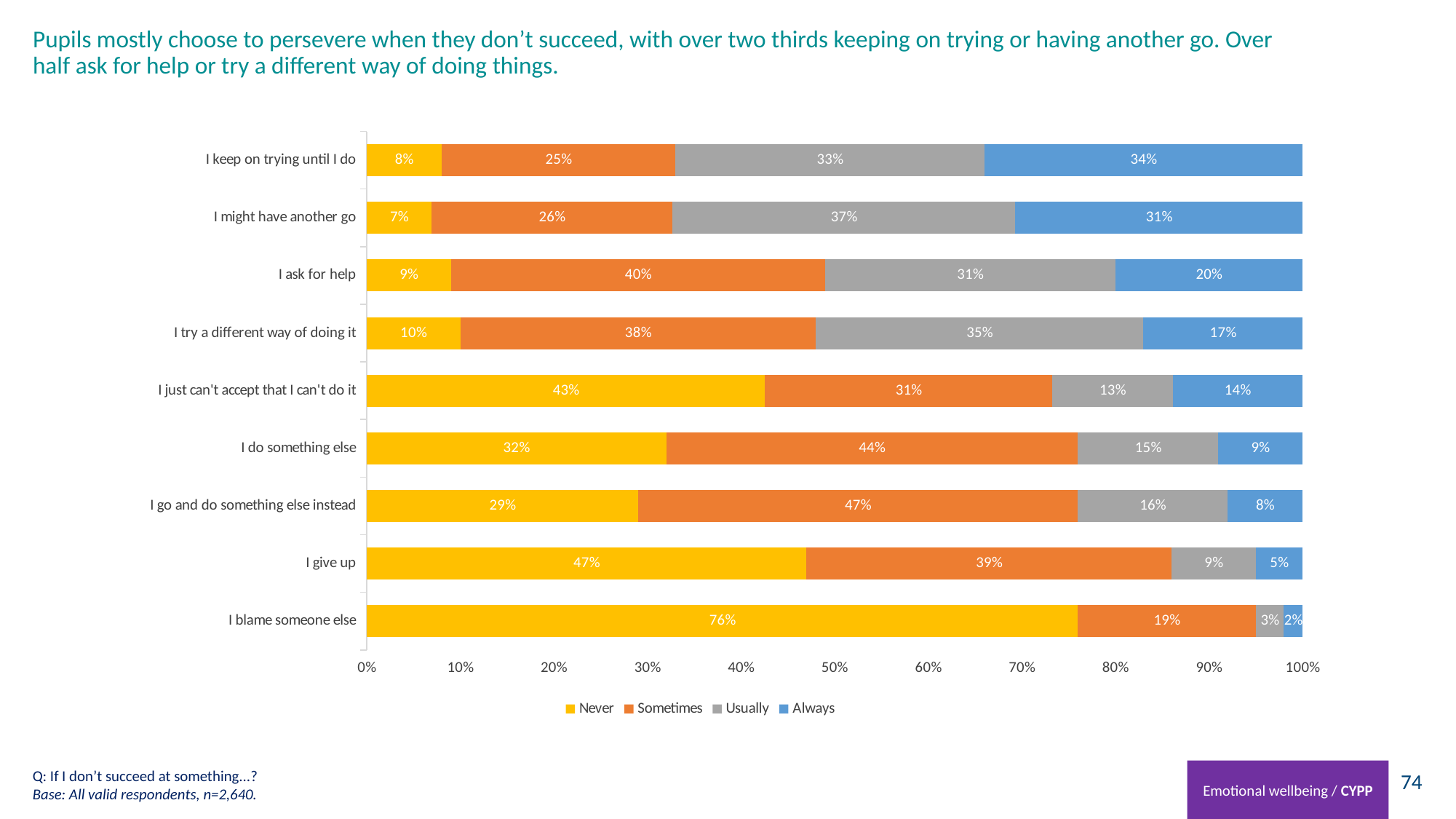
What percentage of pupils say they 'Never' blame someone else? 76% What percentage of pupils say they 'Always' keep on trying until they do? 34% Which is larger: the 'Sometimes' percentage for 'I go and do something else instead' or for 'I do something else'? I go and do something else instead How many series does the legend list? 4 What percentage of pupils say they 'Usually' might have another go? 37% Which colour represents the 'Always' series in the legend? Blue What is the difference between the 'Never' percentage for 'I give up' and for 'I do something else'? 15% Which statement has the lowest 'Always' percentage? I blame someone else What percentage of pupils say they 'Sometimes' ask for help? 40% How many statements (categories) are shown on the chart? 9 What kind of chart is shown on the slide? Stacked bar chart Which statement has the highest 'Never' percentage? I blame someone else